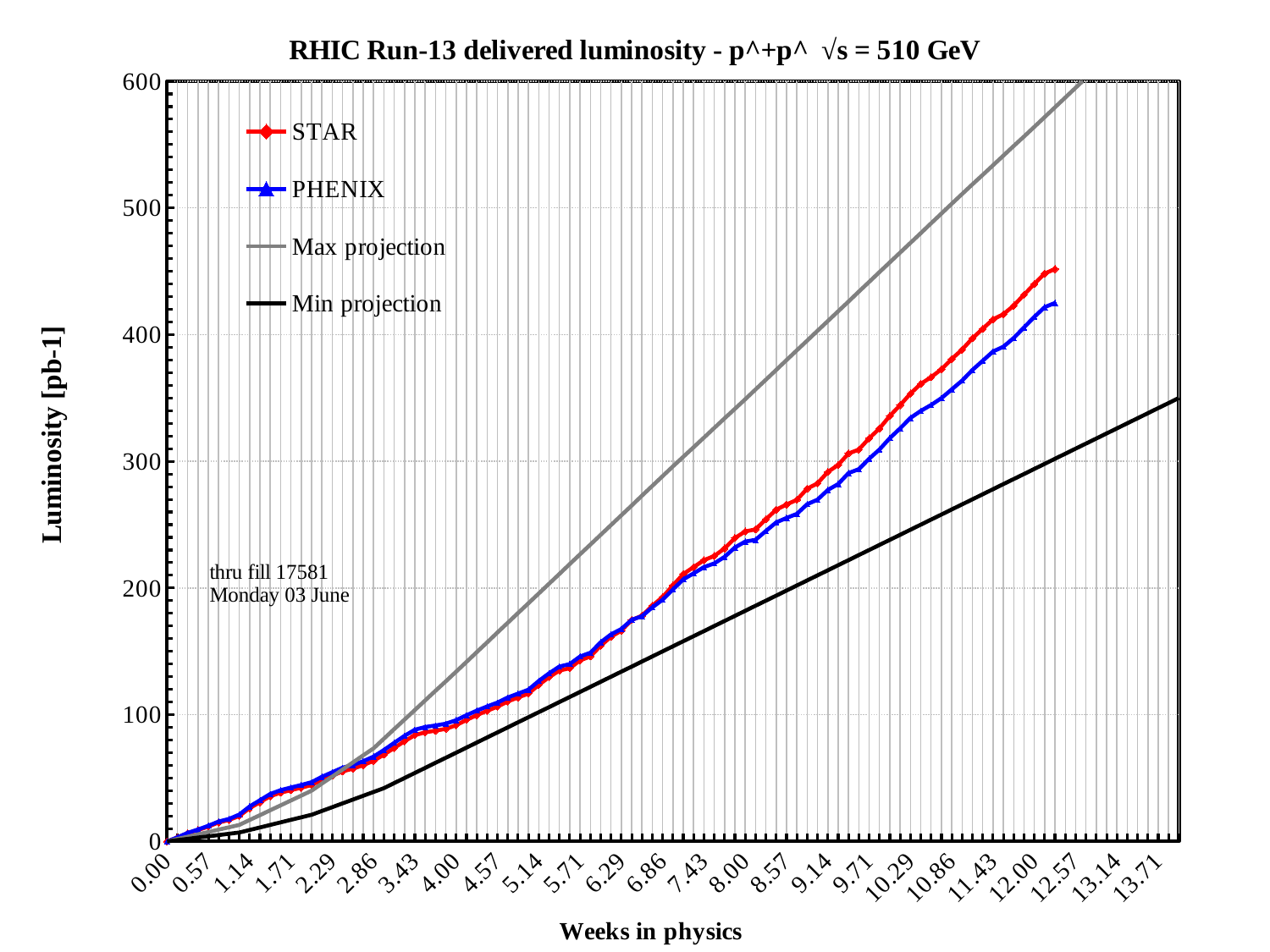
Which series reaches the highest luminosity on the chart? Max projection Is the STAR value at week 4.00 greater or less than 100? less At week 12.00, which is higher, the Max projection or the Min projection? Max projection What is the title of the chart? RHIC Run-13 delivered luminosity - p^+p^ √s = 510 GeV Is the value of the Min projection at week 13.71 greater or less than 400? less Is the final value of the PHENIX series greater or less than 500? less What kind of chart is shown on the slide? line chart At the end of the plotted data, which series is higher, STAR or PHENIX? STAR Do the STAR luminosity values rise or fall as the weeks in physics increase? rise How many series does the legend list? 4 What is the label of the y axis? Luminosity [pb-1]